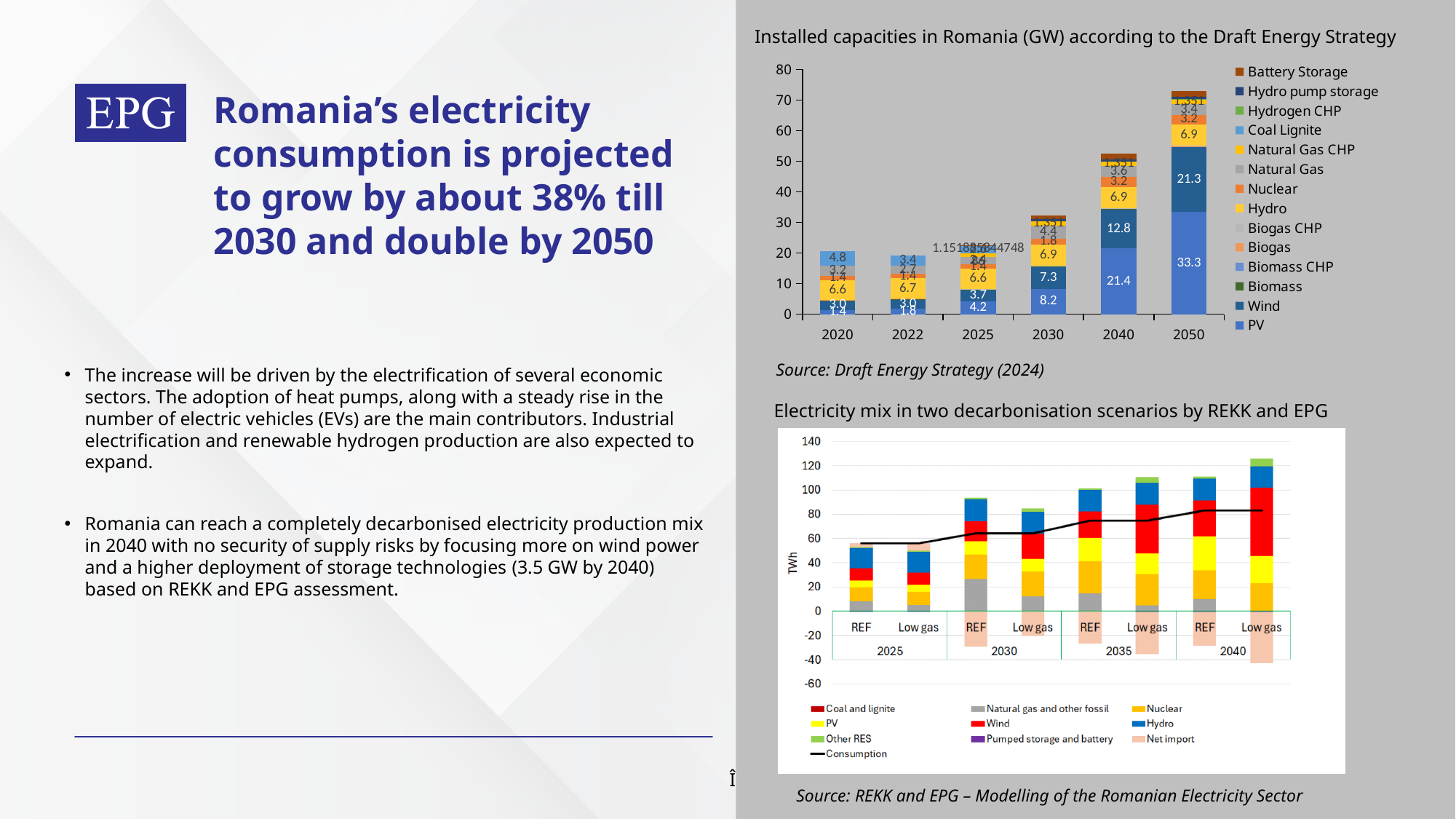
In the 'Installed capacities in Romania (GW)' chart, what is the Hydro capacity in 2030? 6.9 In the 'Electricity mix in two decarbonisation scenarios' chart, is the top of the Low gas 2040 bar greater or less than 100 TWh? greater In the 'Installed capacities in Romania (GW)' chart, by how much does PV capacity increase from 2040 to 2050? 11.9 In the 'Installed capacities in Romania (GW)' chart, which is larger in 2030: PV or Wind capacity? PV In the 'Installed capacities in Romania (GW)' chart, what is the Coal Lignite capacity in 2020? 4.8 In the 'Installed capacities in Romania (GW)' chart, which year has the highest total installed capacity? 2050 In the 'Electricity mix in two decarbonisation scenarios' chart, does the Consumption line rise or fall from 2025 to 2040? Rise In the 'Installed capacities in Romania (GW)' chart, what is the Wind capacity in 2040? 12.8 In the 'Installed capacities in Romania (GW)' chart, what is the PV capacity in 2050? 33.3 What kind of chart is the 'Electricity mix in two decarbonisation scenarios by REKK and EPG' chart? Stacked bar chart with a line How many series does the legend of the 'Installed capacities in Romania (GW)' chart list? 14 How many years are shown on the x axis of the 'Installed capacities in Romania (GW)' chart? 6